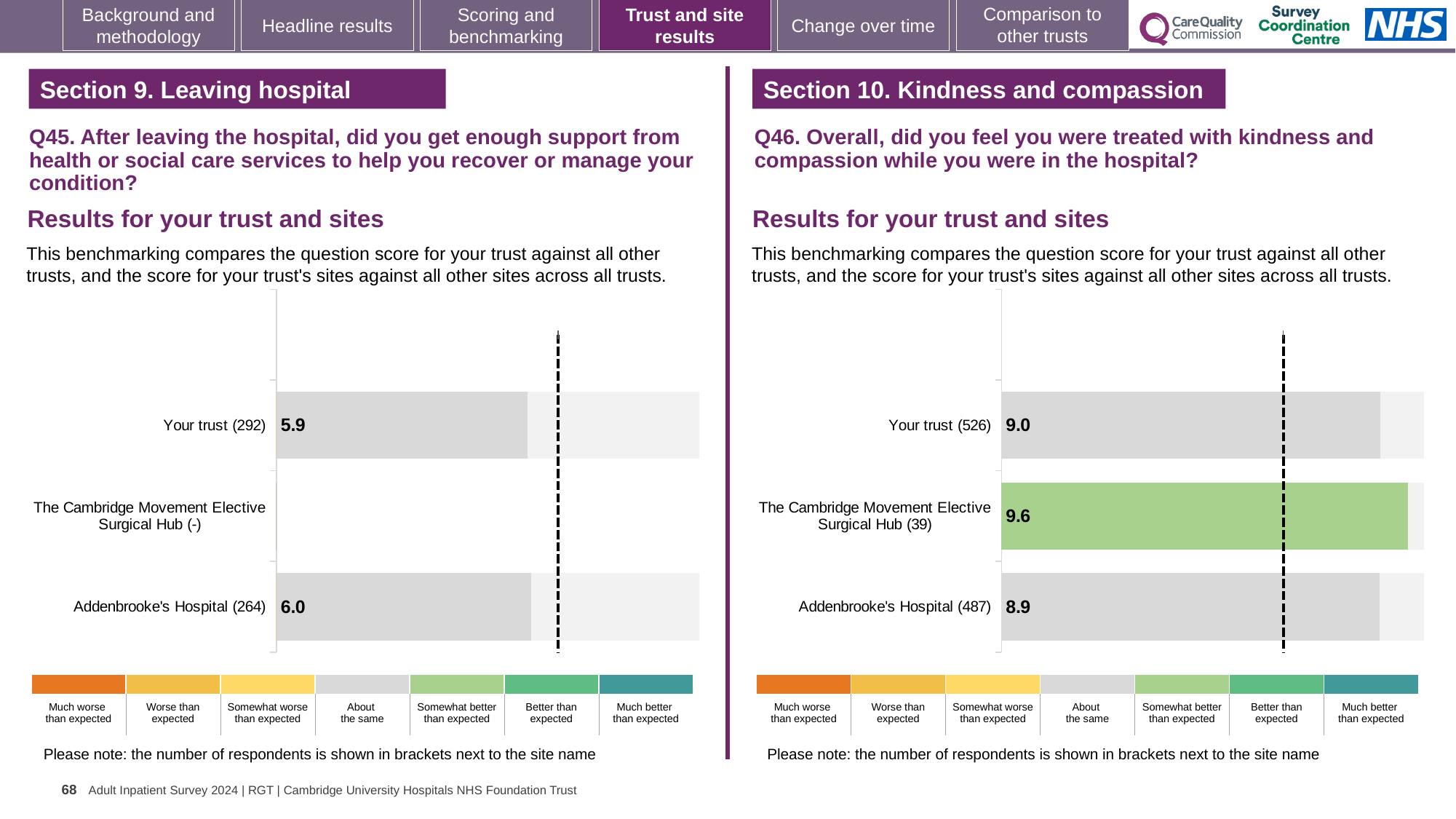
In the Q45 chart on the left, what is the difference between the scores for Addenbrooke's Hospital and Your trust? 0.1 In the Q46 chart on the right, which site or trust has the highest score? The Cambridge Movement Elective Surgical Hub In the Q45 chart on the left, what is the score for Addenbrooke's Hospital? 6.0 In the Q46 chart on the right, what is the score for Addenbrooke's Hospital? 8.9 In the Q46 chart on the right, what is the score for Your trust? 9.0 In the Q45 chart on the left, what is the score for Your trust? 5.9 What type of chart is used for the Q45 results on the left? Bar chart In the Q46 chart on the right, what is the difference between the scores for The Cambridge Movement Elective Surgical Hub and Addenbrooke's Hospital? 0.7 In the Q46 chart on the right, what is the score for The Cambridge Movement Elective Surgical Hub? 9.6 In the Q46 chart on the right, which benchmark category does the colour of The Cambridge Movement Elective Surgical Hub bar correspond to? Somewhat better than expected In the Q46 chart on the right, how many respondents are shown for Your trust? 526 In the Q46 chart on the right, which site or trust has the lowest score? Addenbrooke's Hospital